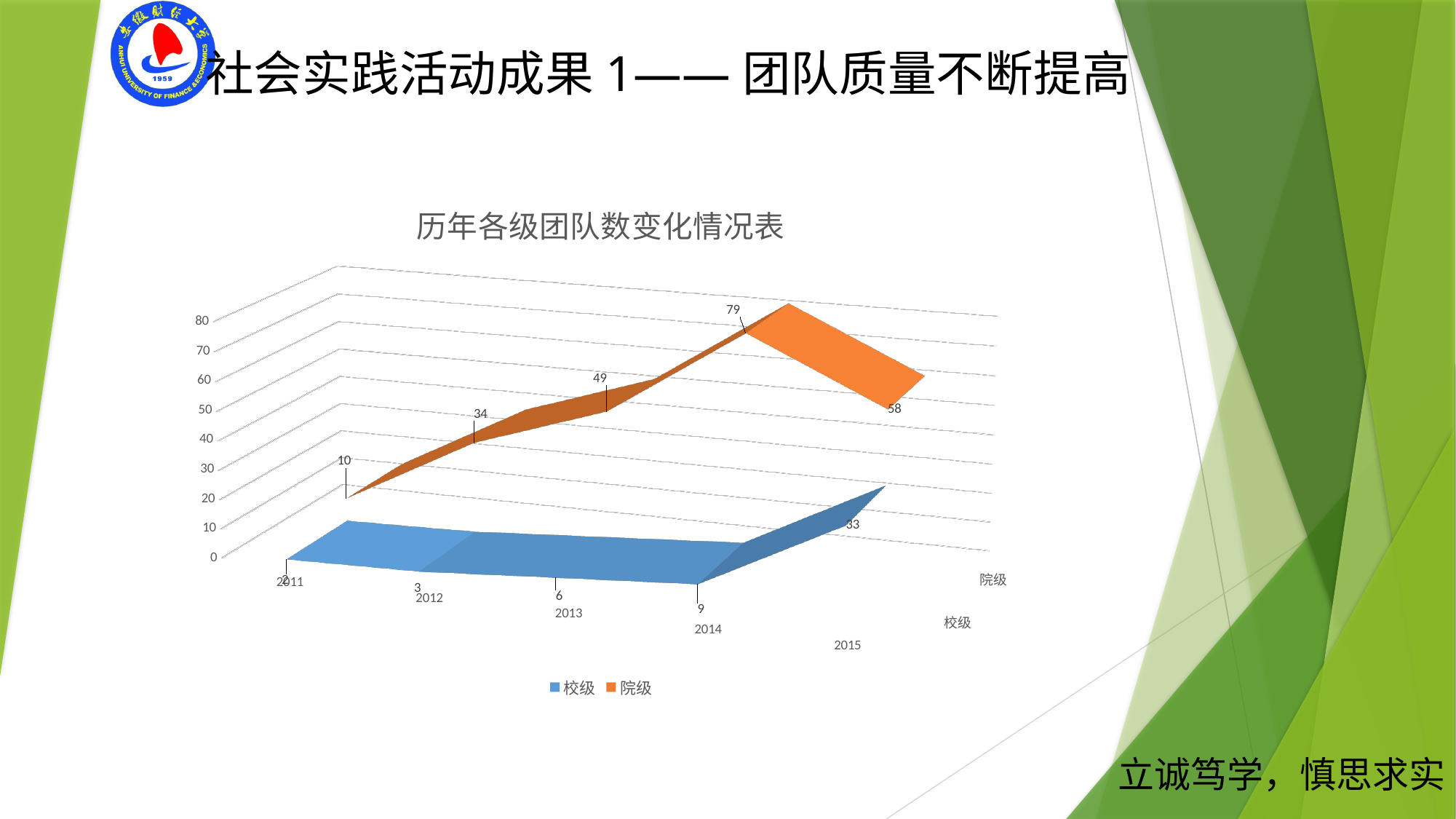
What is the value for 院级 in 2012? 34 What kind of chart is shown on the slide? 3D line chart What is the difference between the 院级 values for 2014 and 2015? 21 In which year is the 院级 value lowest? 2011 How many years are shown on the x axis of the chart? 5 What is the title of the chart? 历年各级团队数变化情况表 What is the value for 院级 in 2014? 79 How many series does the legend list? 2 Does the 校级 value rise or fall from 2012 to 2015? rise Which is larger in 2013, the 校级 value or the 院级 value? 院级 What is the value for 校级 in 2015? 33 In which year is the 院级 value highest? 2014